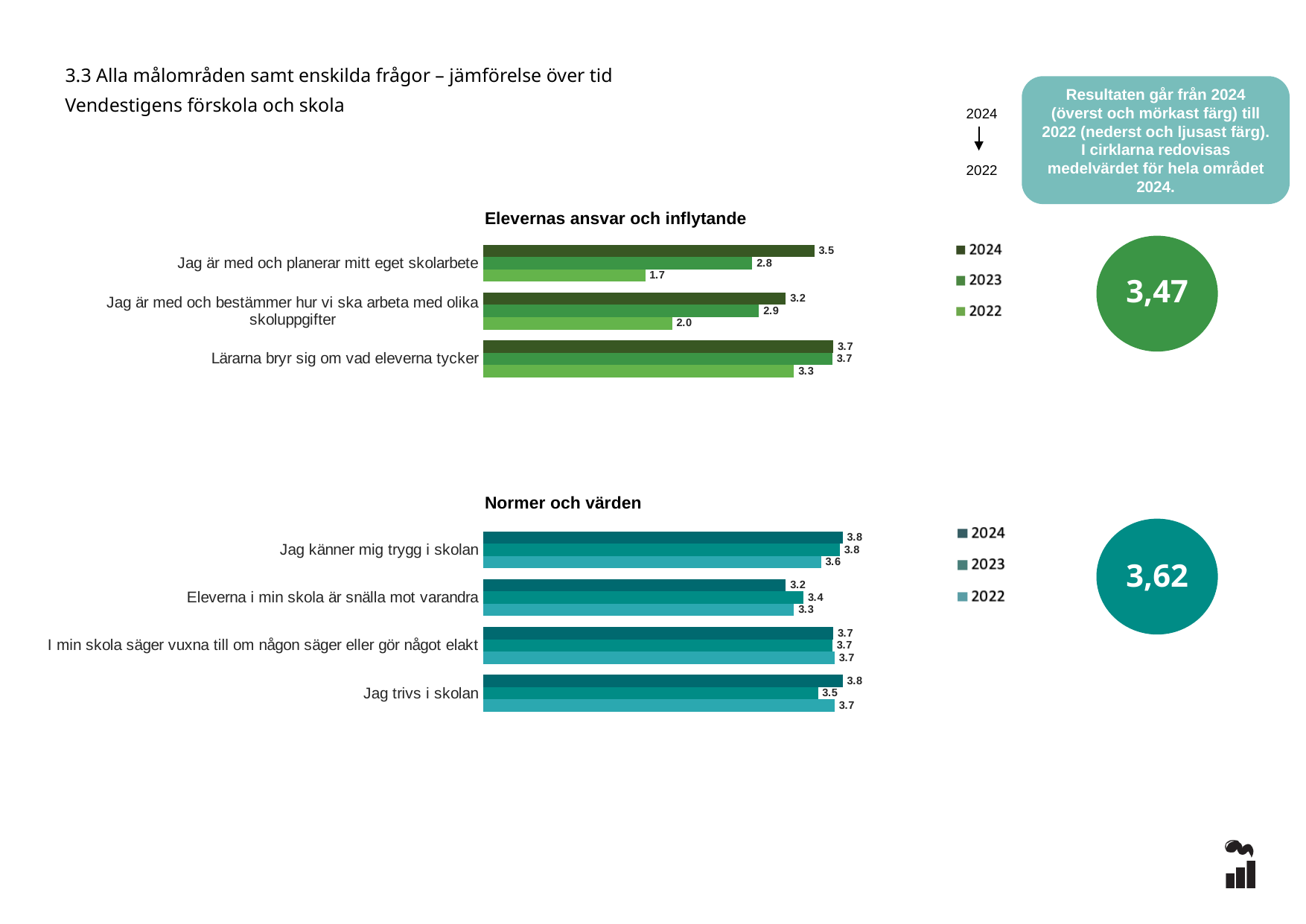
In the 'Elevernas ansvar och inflytande' chart, which category has the lowest 2022 value? Jag är med och planerar mitt eget skolarbete In the 'Normer och värden' chart, what is the 2023 value for 'Eleverna i min skola är snälla mot varandra'? 3.4 In the 'Normer och värden' chart, which is larger: the 2024 value for 'Jag trivs i skolan' or the 2024 value for 'Eleverna i min skola är snälla mot varandra'? Jag trivs i skolan In the 'Elevernas ansvar och inflytande' chart, what is the 2022 value for 'Jag är med och bestämmer hur vi ska arbeta med olika skoluppgifter'? 2.0 In the 'Normer och värden' chart, which category has the lowest 2024 value? Eleverna i min skola är snälla mot varandra In the 'Normer och värden' chart, what is the 2022 value for 'Jag trivs i skolan'? 3.7 In the 'Elevernas ansvar och inflytande' chart, what is the 2024 value for 'Jag är med och planerar mitt eget skolarbete'? 3.5 What is the mean value shown in the circle next to the 'Normer och värden' chart? 3,62 In the 'Normer och värden' chart, how many categories are shown? 4 In the 'Elevernas ansvar och inflytande' chart, what is the difference between the 2024 and 2022 values for 'Jag är med och planerar mitt eget skolarbete'? 1.8 What kind of chart is 'Normer och värden'? Bar chart In the 'Elevernas ansvar och inflytande' chart, how many series does the legend list? 3